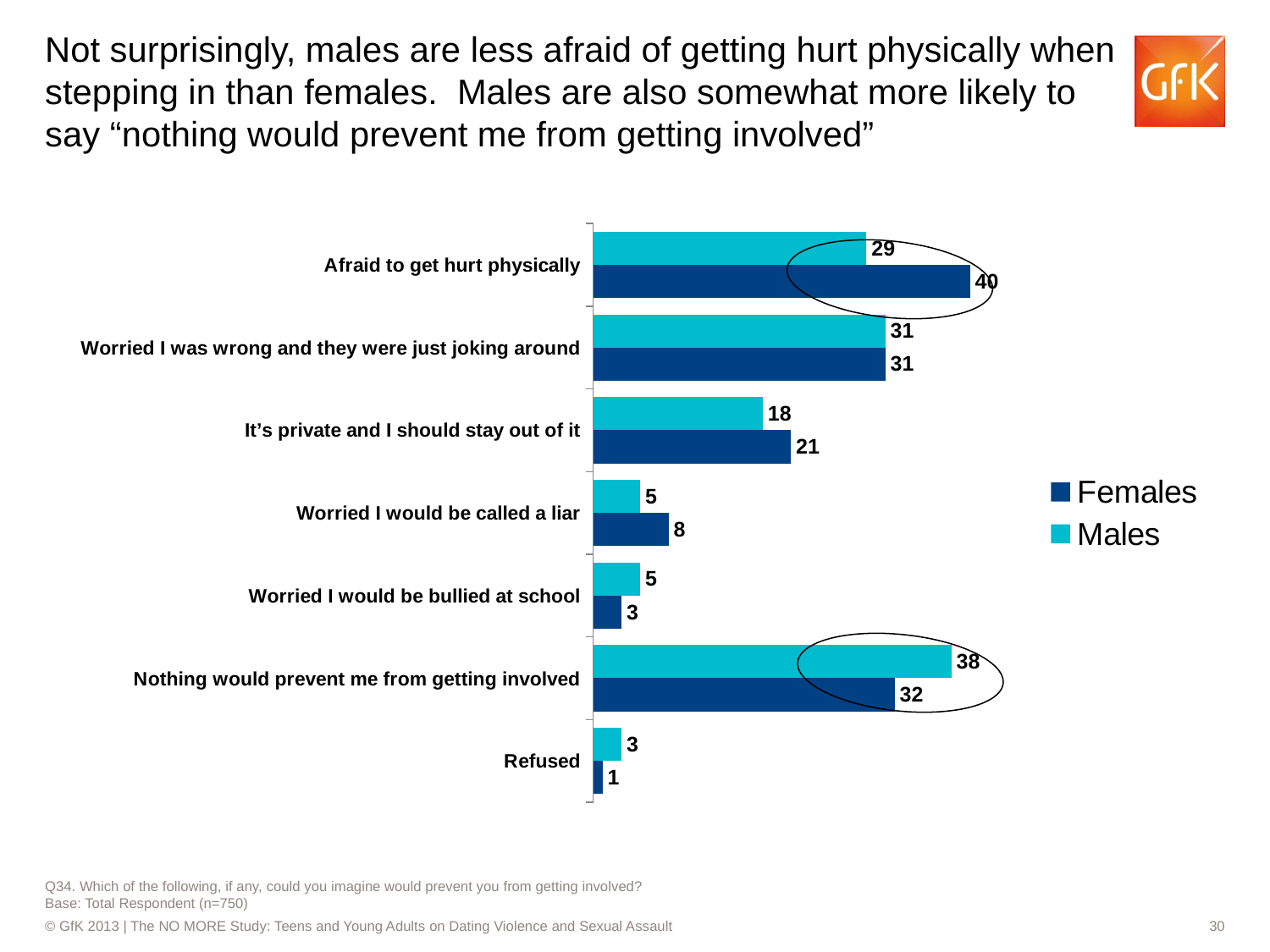
How many series does the legend list? 2 What is the value for Males for "Nothing would prevent me from getting involved"? 38 Which category has the highest value for Females? Afraid to get hurt physically What is the value for Males for "It's private and I should stay out of it"? 18 What kind of chart is shown on the slide? Bar chart What is the difference between the Males and Females values for "Nothing would prevent me from getting involved"? 6 What is the difference between the Females and Males values for "Afraid to get hurt physically"? 11 Which colour represents Males in the chart? Light blue (cyan) How many categories are shown on the chart? 7 What is the value for Females for "Afraid to get hurt physically"? 40 For "Worried I would be bullied at school", which is larger, the Males value or the Females value? Males Which category has the lowest value for Females? Refused